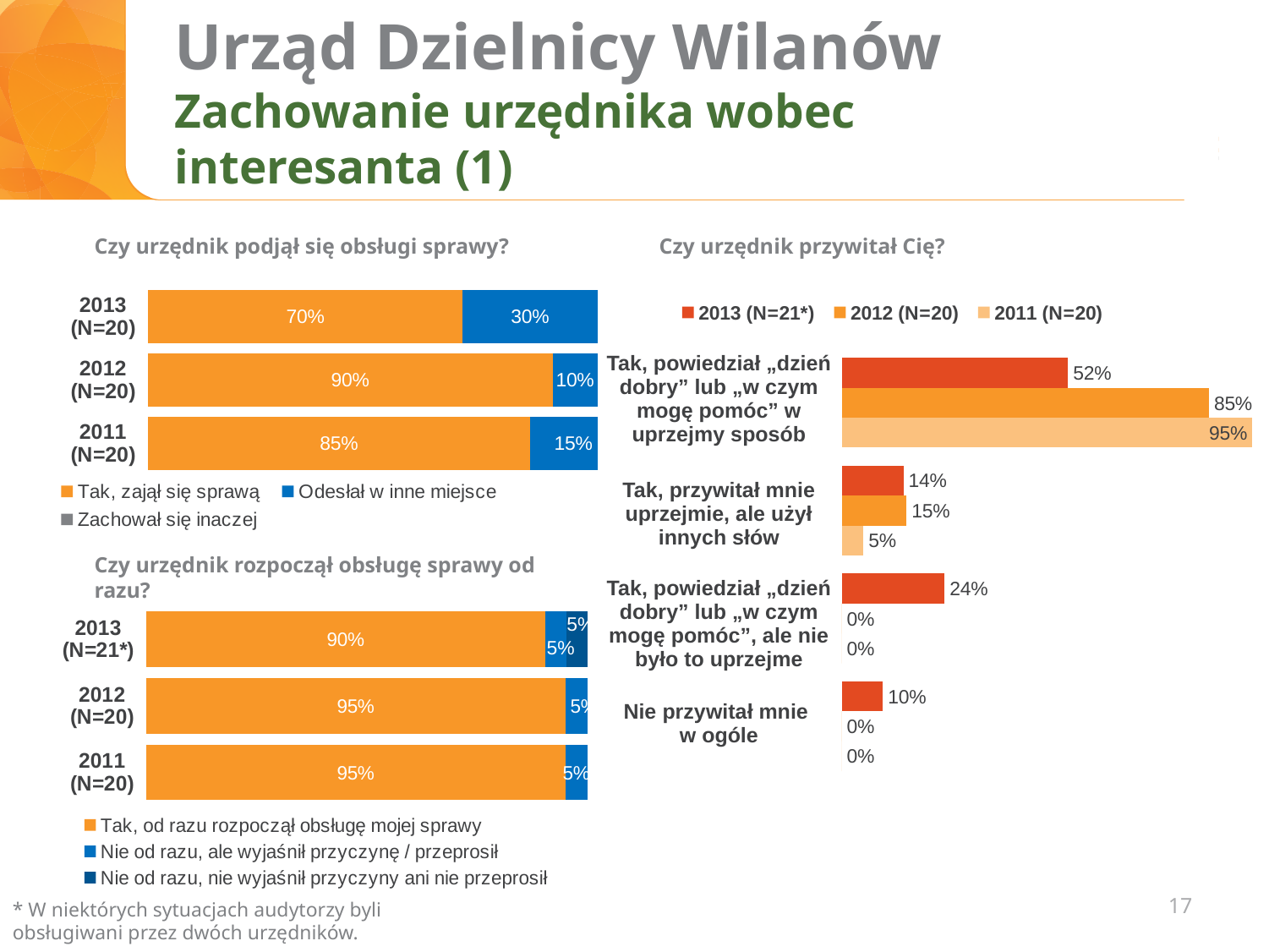
In the chart "Czy urzędnik podjął się obsługi sprawy?", what is the value for "Odesłał w inne miejsce" in 2011 (N=20)? 15% In the chart "Czy urzędnik przywitał Cię?", what is the value for 2013 (N=21*) in the category "Nie przywitał mnie w ogóle"? 10% In the chart "Czy urzędnik rozpoczął obsługę sprawy od razu?", which year has the lowest value for "Tak, od razu rozpoczął obsługę mojej sprawy"? 2013 (N=21*) What kind of chart is "Czy urzędnik przywitał Cię?"? bar chart In the chart "Czy urzędnik podjął się obsługi sprawy?", what is the difference between the "Odesłał w inne miejsce" values for 2013 and 2012? 20% In the chart "Czy urzędnik podjął się obsługi sprawy?", what is the value for "Tak, zajął się sprawą" in 2013 (N=20)? 70% In the chart "Czy urzędnik rozpoczął obsługę sprawy od razu?", what is the value for "Tak, od razu rozpoczął obsługę mojej sprawy" in 2013 (N=21*)? 90% In the chart "Czy urzędnik podjął się obsługi sprawy?", which year has the highest value for "Tak, zajął się sprawą"? 2012 (N=20) How many series does the legend of the chart "Czy urzędnik podjął się obsługi sprawy?" list? 3 How many categories are shown in the chart "Czy urzędnik przywitał Cię?"? 4 In the chart "Czy urzędnik przywitał Cię?", what is the difference between the 2011 (N=20) and 2013 (N=21*) values for "Tak, powiedział „dzień dobry” lub „w czym mogę pomóc” w uprzejmy sposób"? 43% In the chart "Czy urzędnik przywitał Cię?", what is the value for 2011 (N=20) in the category "Tak, powiedział „dzień dobry” lub „w czym mogę pomóc” w uprzejmy sposób"? 95%